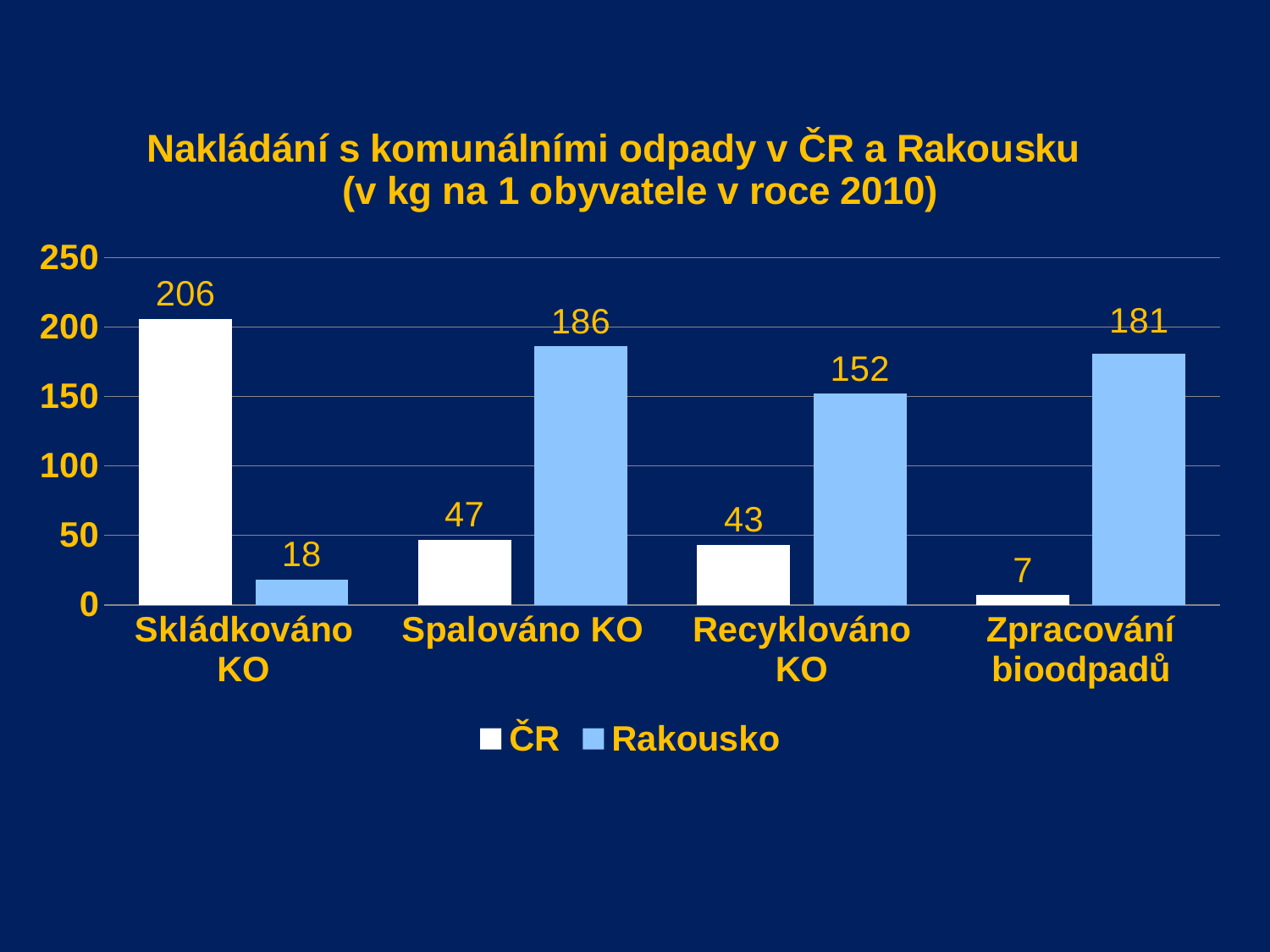
How many categories are shown on the x axis? 4 In which category does ČR have its highest value? Skládkováno KO What is the value for Rakousko in the Recyklováno KO category? 152 Which is larger in the Recyklováno KO category, ČR or Rakousko? Rakousko What is the difference between the ČR and Rakousko values for Skládkováno KO? 188 What is the value for ČR in the Zpracování bioodpadů category? 7 What is the difference between the Rakousko and ČR values for Spalováno KO? 139 What is the value for ČR in the Skládkováno KO category? 206 How many series does the legend list? 2 What is the value for Rakousko in the Spalováno KO category? 186 In which category does Rakousko have its lowest value? Skládkováno KO What kind of chart is shown on the slide? Bar chart